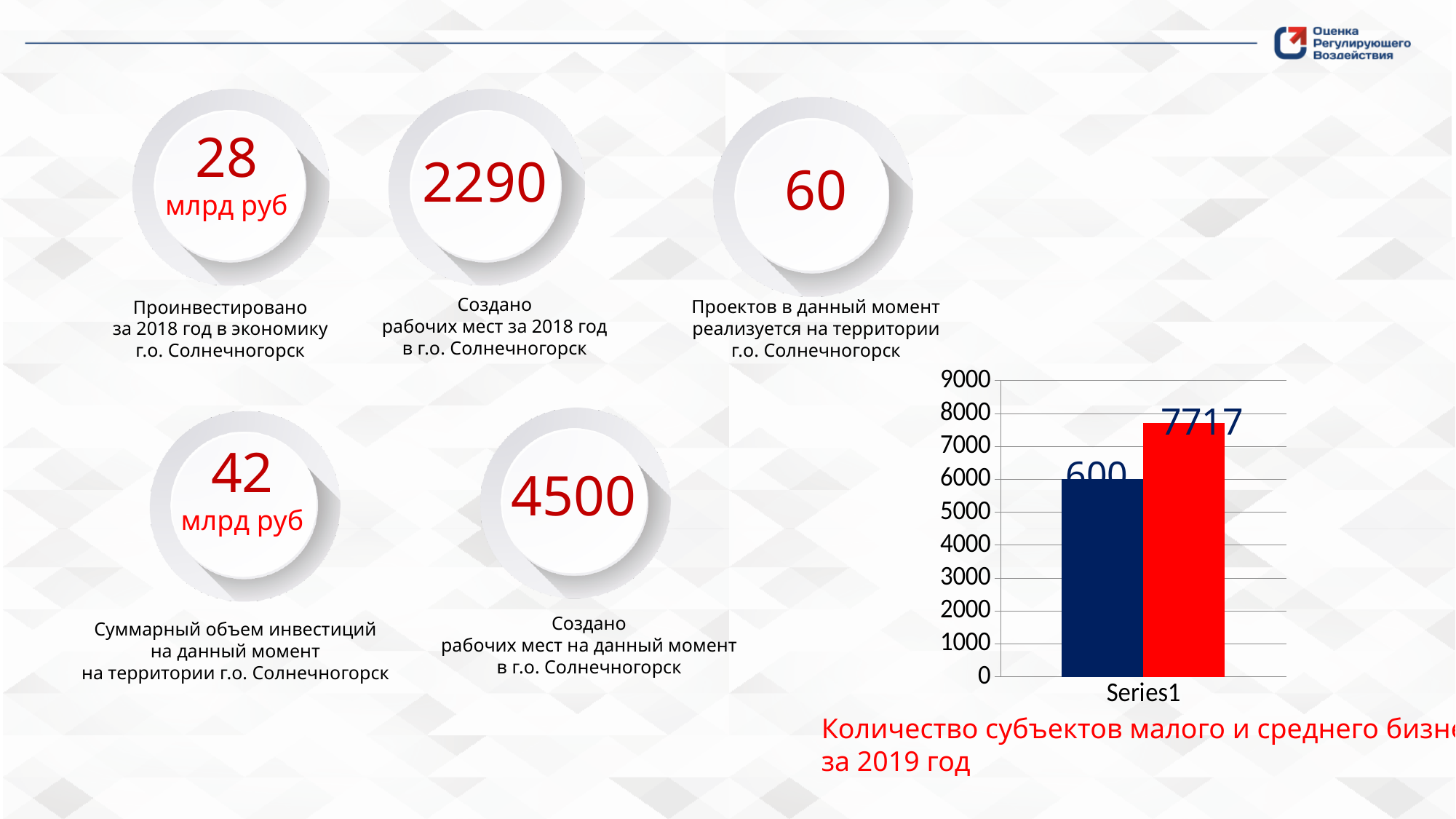
What kind of chart is shown on the right side of the slide? bar chart Which bar in the chart has the lowest value? the dark blue bar What is the highest value shown on the y axis of the chart? 9000 What is the value shown on the red bar in the chart? 7717 Is the value of the dark blue bar in the chart greater or less than 5000? greater Is the value of the red bar in the chart greater or less than 8000? less How many bars are plotted in the chart? 2 Which bar in the chart is taller, the dark blue one or the red one? the red one What label appears on the x axis of the chart? Series1 Which bar in the chart has the highest value? the red bar (7717)